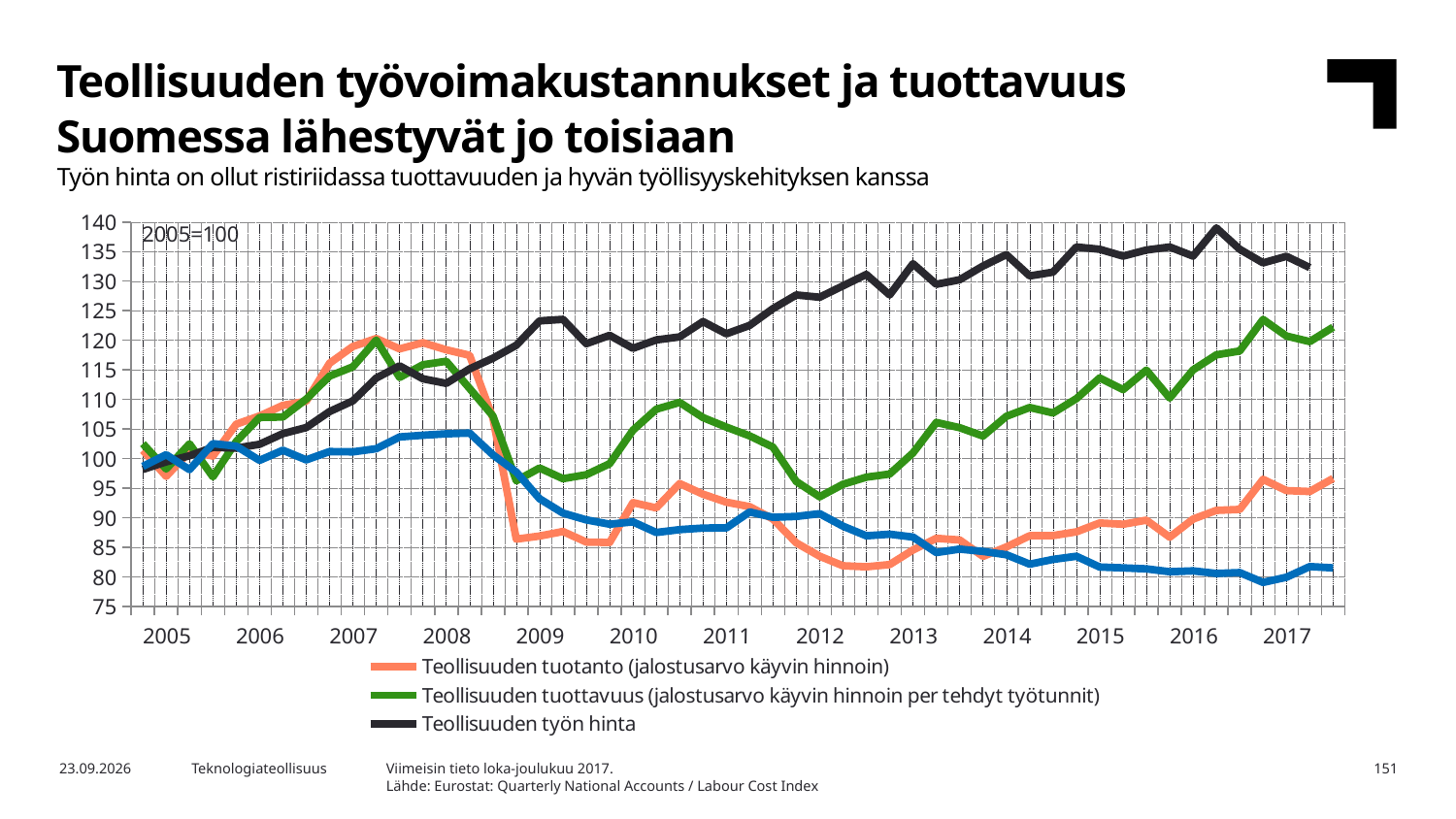
What kind of chart is shown on the slide? line chart At the start of 2013, which series is higher: 'Teollisuuden tuottavuus' or 'Teollisuuden tuotanto (jalostusarvo käyvin hinnoin)'? Teollisuuden tuottavuus At the end of 2017, which series is higher: 'Teollisuuden työn hinta' or 'Teollisuuden tuotanto (jalostusarvo käyvin hinnoin)'? Teollisuuden työn hinta Is the value of 'Teollisuuden tuottavuus' at the end of 2017 greater or less than 115? greater What colour is the 'Teollisuuden työn hinta' line? black Is the value of 'Teollisuuden tuotanto (jalostusarvo käyvin hinnoin)' at the start of 2012 greater or less than 90? less Is the value of 'Teollisuuden työn hinta' at the end of 2017 greater or less than 130? greater How many series does the legend list? 3 Does the 'Teollisuuden tuotanto (jalostusarvo käyvin hinnoin)' line rise or fall between 2008 and 2009? fall Does the 'Teollisuuden työn hinta' line rise or fall overall from 2005 to 2017? rise What base year and index value is noted in the top-left corner of the chart? 2005=100